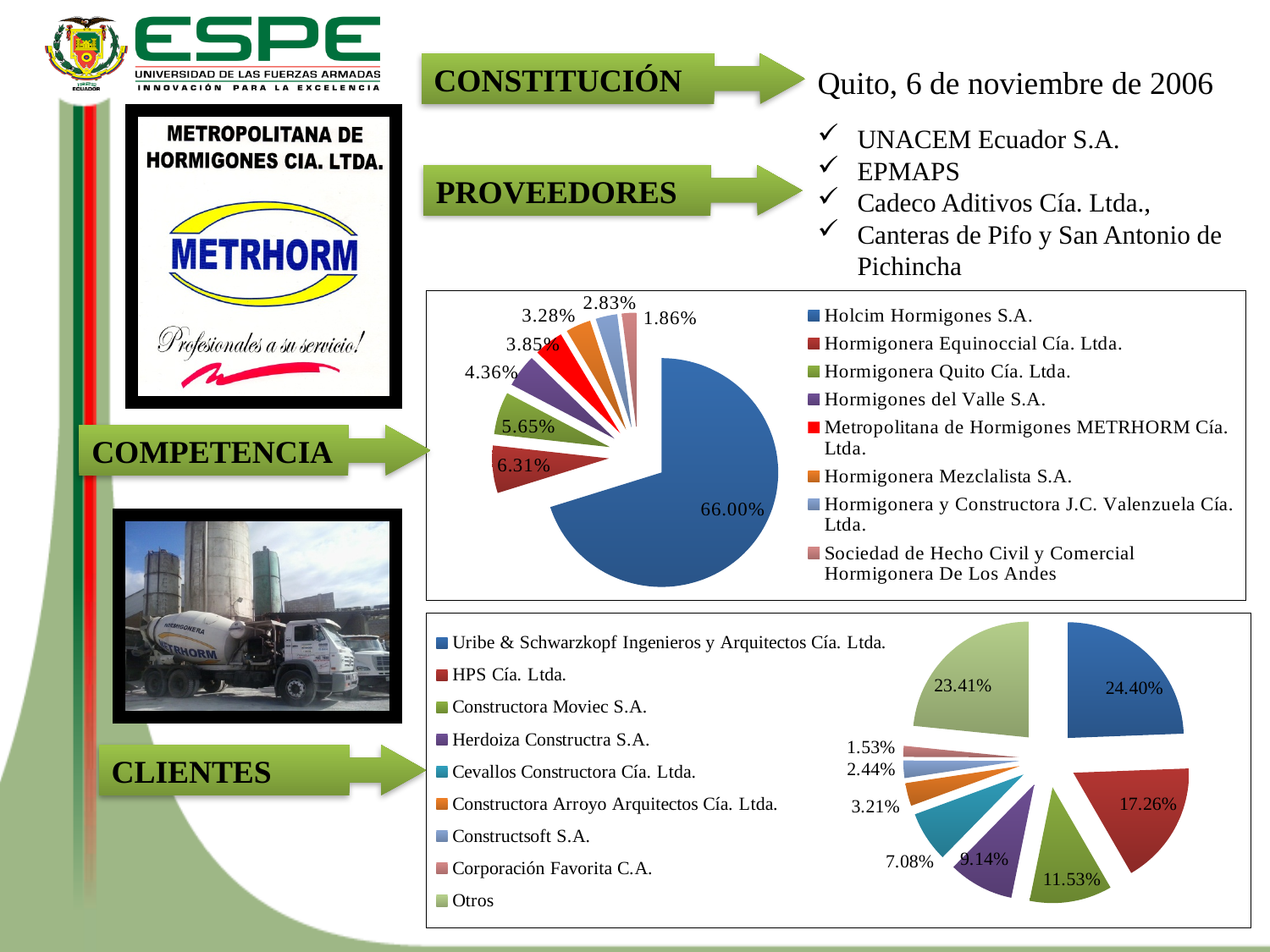
In the lower pie chart (next to CLIENTES), how many categories are listed in the legend? 9 In the upper pie chart (next to COMPETENCIA), which company has the smallest slice? Sociedad de Hecho Civil y Comercial Hormigonera De Los Andes In the lower pie chart (next to CLIENTES), what share does HPS Cía. Ltda. hold? 17.26% In the lower pie chart (next to CLIENTES), which is larger: the share of Constructora Moviec S.A. or Herdoiza Constructra S.A.? Constructora Moviec S.A. What type of chart is used in the lower chart (next to CLIENTES)? Pie chart In the upper pie chart (next to COMPETENCIA), what is the difference between the shares of Hormigonera Equinoccial Cía. Ltda. and Hormigonera Quito Cía. Ltda.? 0.66% In the upper pie chart (next to COMPETENCIA), what share does Metropolitana de Hormigones METRHORM Cía. Ltda. hold? 3.85% In the lower pie chart (next to CLIENTES), what colour is the slice for Otros? Light green In the upper pie chart (next to COMPETENCIA), what share does Holcim Hormigones S.A. hold? 66.00% In the upper pie chart (next to COMPETENCIA), how many companies are shown in the legend? 8 In the lower pie chart (next to CLIENTES), what is the difference between the shares of Uribe & Schwarzkopf Ingenieros y Arquitectos Cía. Ltda. and Otros? 0.99% In the lower pie chart (next to CLIENTES), which client has the largest slice? Uribe & Schwarzkopf Ingenieros y Arquitectos Cía. Ltda.